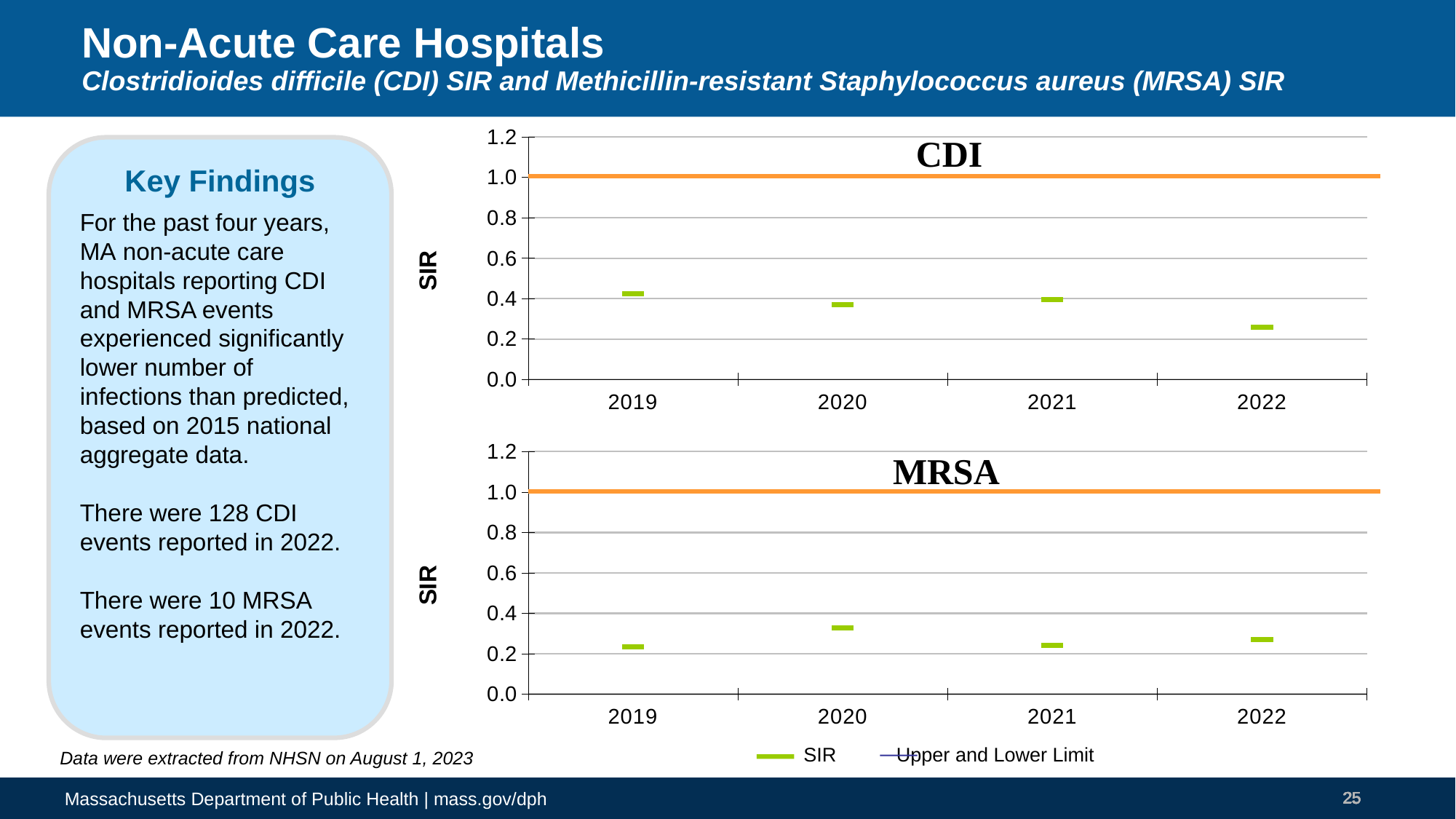
In the CDI chart, which year has the larger SIR value, 2019 or 2022? 2019 In the MRSA chart, which year has the highest SIR value? 2020 In the MRSA chart, is the SIR value for 2020 greater or less than 0.4? less How many series does the legend below the MRSA chart list? 2 In the CDI chart, is the SIR value for 2019 greater or less than 0.4? greater How many years are plotted in the CDI chart? 4 In the MRSA chart, which year has the larger SIR value, 2020 or 2021? 2020 What is the y-axis label on the MRSA chart? SIR In the CDI chart, is the SIR value for 2022 greater or less than 0.4? less In the CDI chart, which year has the lowest SIR value? 2022 At what value on the y axis is the orange 'Upper and Lower Limit' line drawn in the CDI chart? 1.0